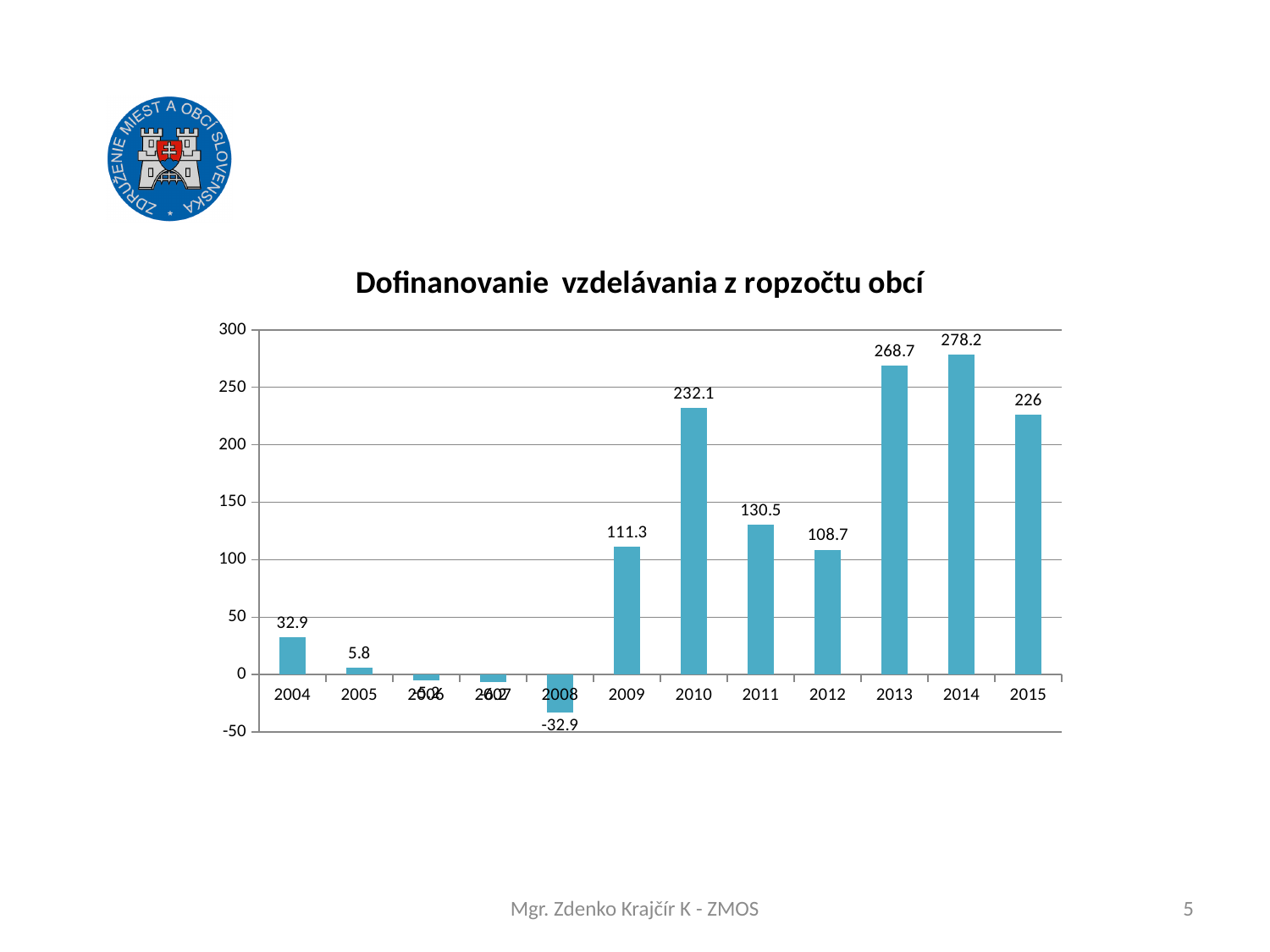
Which year has the highest value? 2014 Which is larger, the value for 2011 or the value for 2012? 2011 Is the value for 2009 greater or less than 100? greater What is the value for 2008? -32.9 What is the difference between the values for 2010 and 2009? 120.8 What is the value for 2015? 226 What kind of chart is shown on the slide? bar chart What is the title of the chart? Dofinanovanie vzdelávania z ropzočtu obcí What is the value for 2010? 232.1 Which year has the lowest value? 2008 What is the difference between the values for 2014 and 2013? 9.5 How many years are shown on the x axis? 12